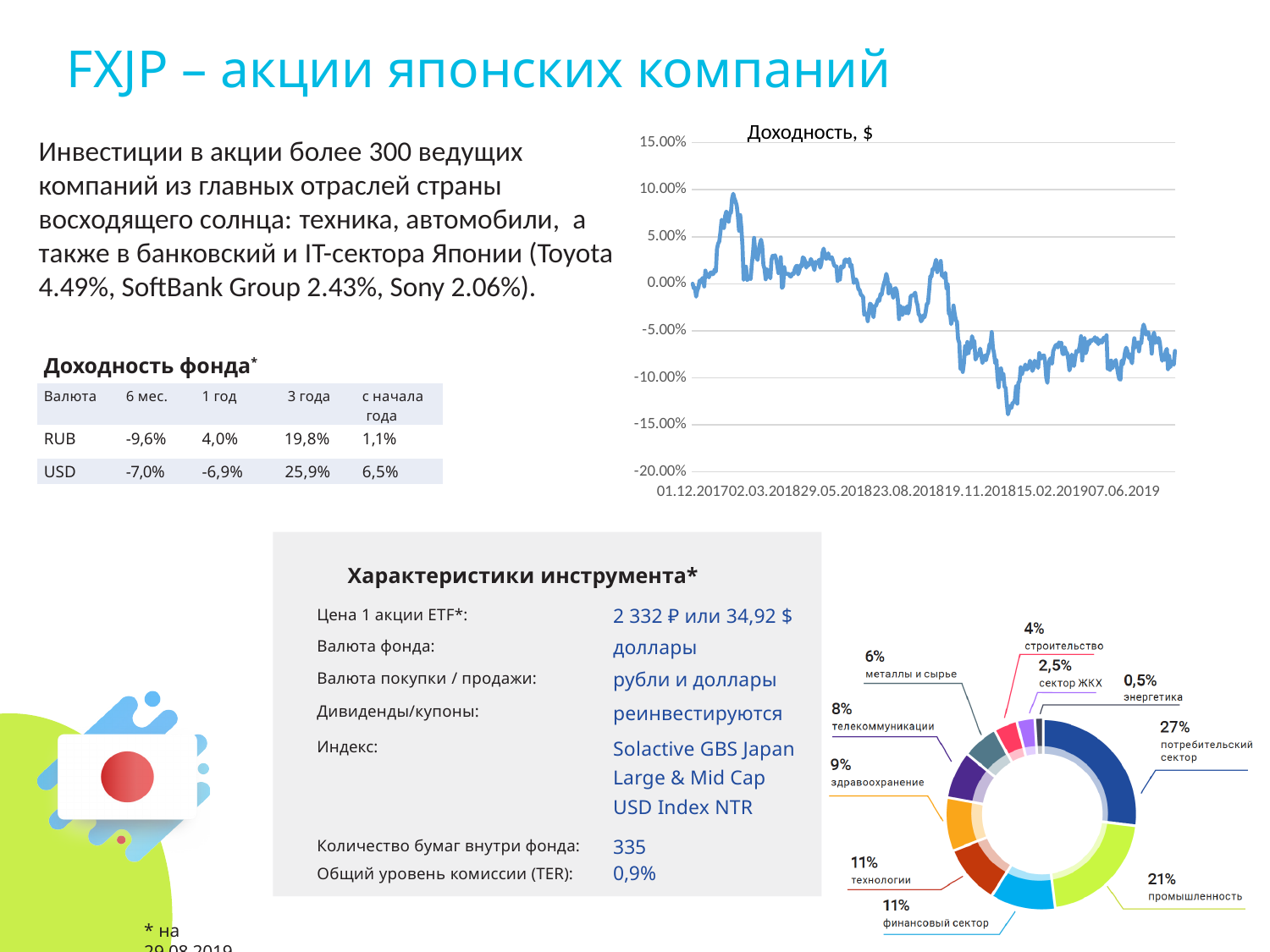
In the chart titled "Доходность, $", is the value at the end of the period (around 07.06.2019) greater or less than 0.00%? less In the donut chart at the bottom right, what is the share of промышленность? 21% In the donut chart at the bottom right, which is larger: the share of телекоммуникации or the share of металлы и сырье? телекоммуникации What type of chart is the chart titled "Доходность, $"? line chart In the donut chart at the bottom right, which sector has the smallest share? энергетика In the chart titled "Доходность, $", what is the lowest value shown on the vertical axis? -20.00% How many sectors are shown in the donut chart at the bottom right? 10 In the donut chart at the bottom right, what is the share of здравоохранение? 9% In the chart titled "Доходность, $", do the values overall rise or fall from the start to the end of the period? fall In the donut chart at the bottom right, which sector has the largest share? потребительский сектор In the chart titled "Доходность, $", is the highest value reached in early 2018 greater or less than 5.00%? greater In the donut chart at the bottom right, what is the difference between the shares of потребительский сектор and промышленность? 6%